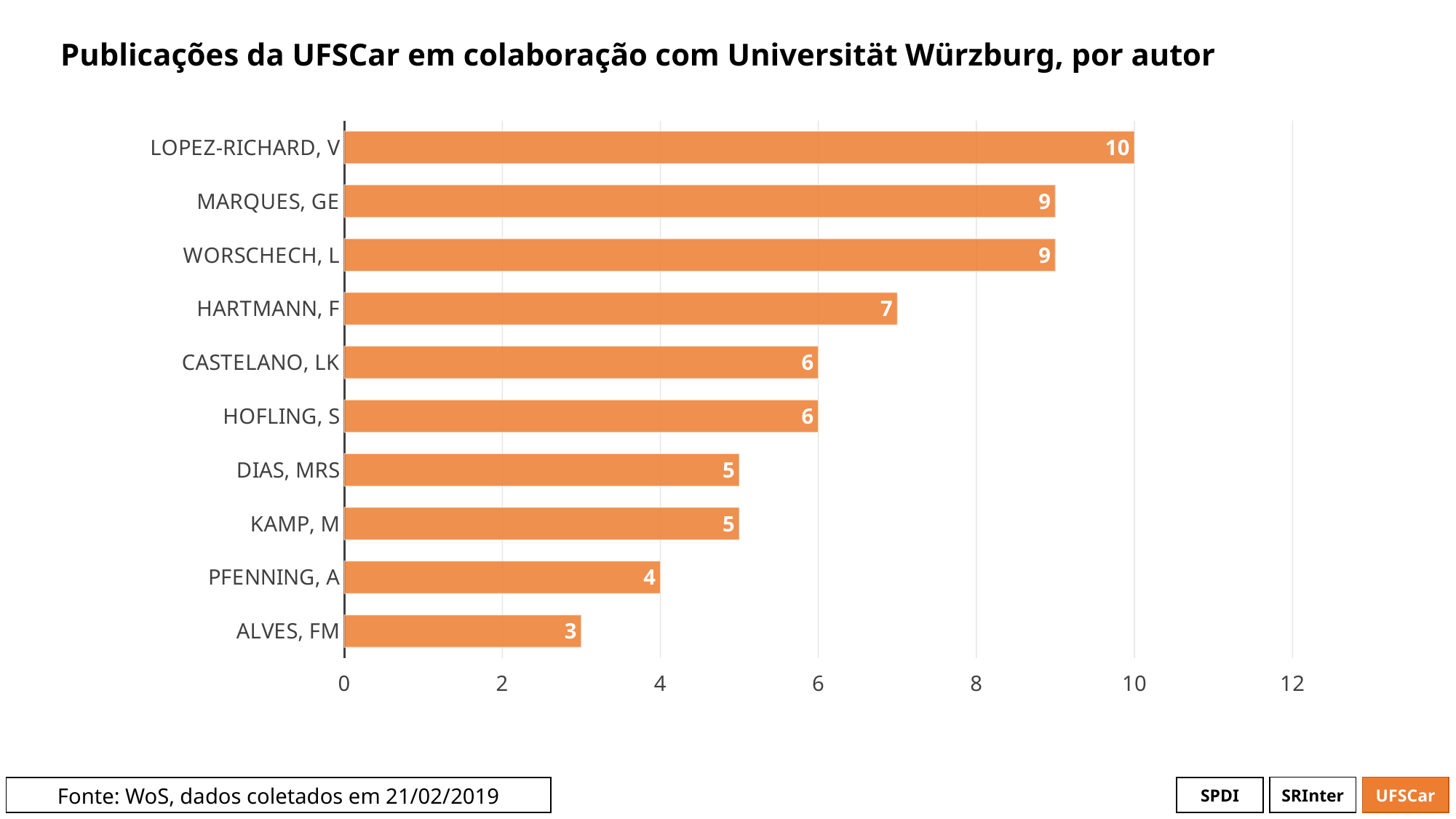
How many authors are shown in the chart? 10 How many publications does LOPEZ-RICHARD, V have? 10 Is the value for WORSCHECH, L greater or less than 8? greater What is the value for HARTMANN, F? 7 What kind of chart is shown on the slide? bar chart Which author has the lowest number of publications? ALVES, FM What is the difference between the values for MARQUES, GE and HARTMANN, F? 2 Which author has the highest number of publications? LOPEZ-RICHARD, V Which is larger, the value for CASTELANO, LK or the value for DIAS, MRS? CASTELANO, LK What is the title of the chart? Publicações da UFSCar em colaboração com Universität Würzburg, por autor What is the difference between the values for LOPEZ-RICHARD, V and ALVES, FM? 7 What is the value for PFENNING, A? 4